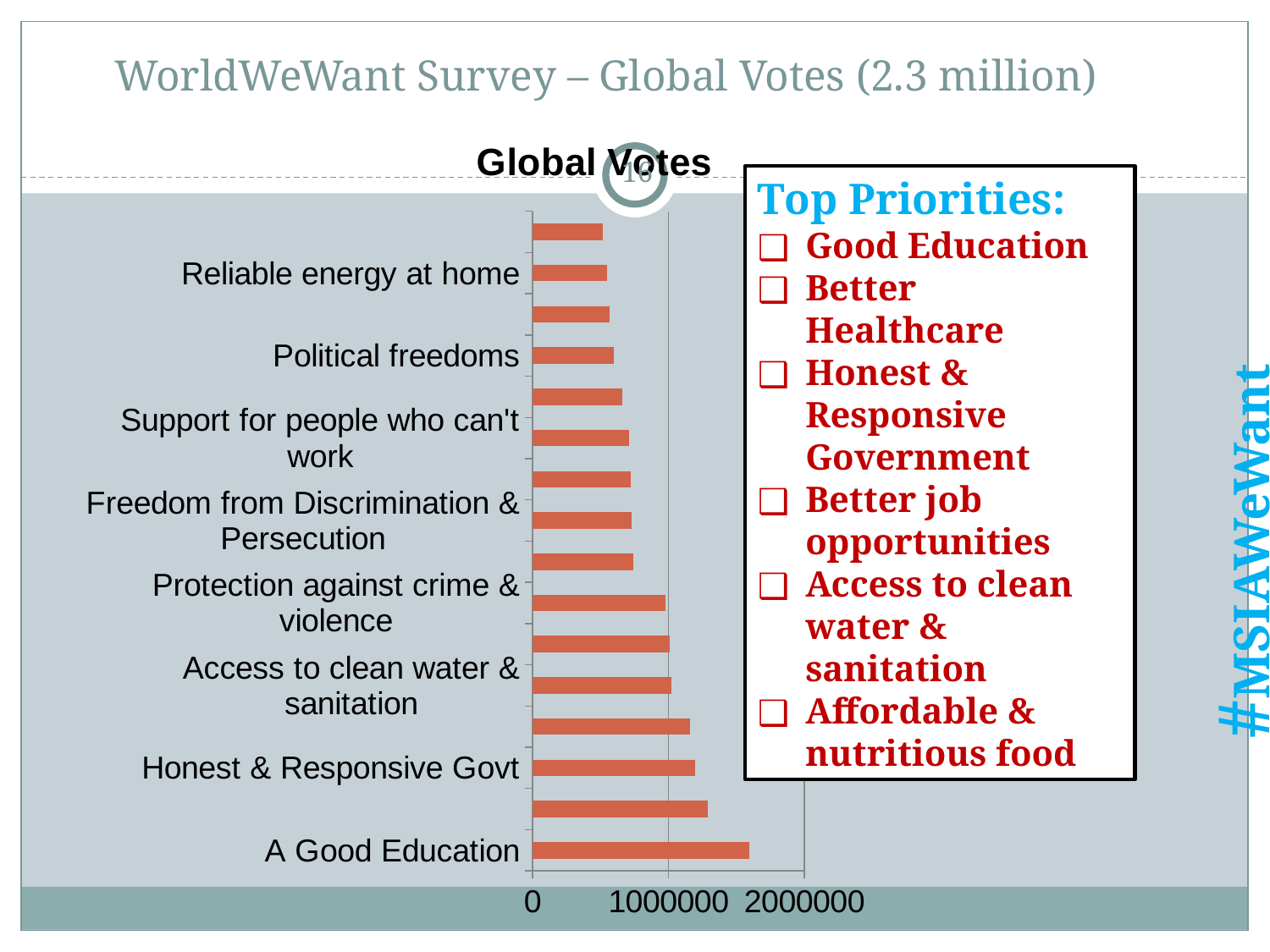
Is the value for Reliable energy at home greater or less than 1000000? less Is the value for A Good Education greater or less than 2000000? less Which has more global votes, A Good Education or Honest & Responsive Govt? A Good Education Is the value for Honest & Responsive Govt greater or less than 1000000? greater What is the title of the chart? Global Votes What kind of chart is shown on the slide? bar chart Which has more global votes, Political freedoms or Honest & Responsive Govt? Honest & Responsive Govt Which category has the highest number of global votes? A Good Education How many bars are plotted in the chart? 16